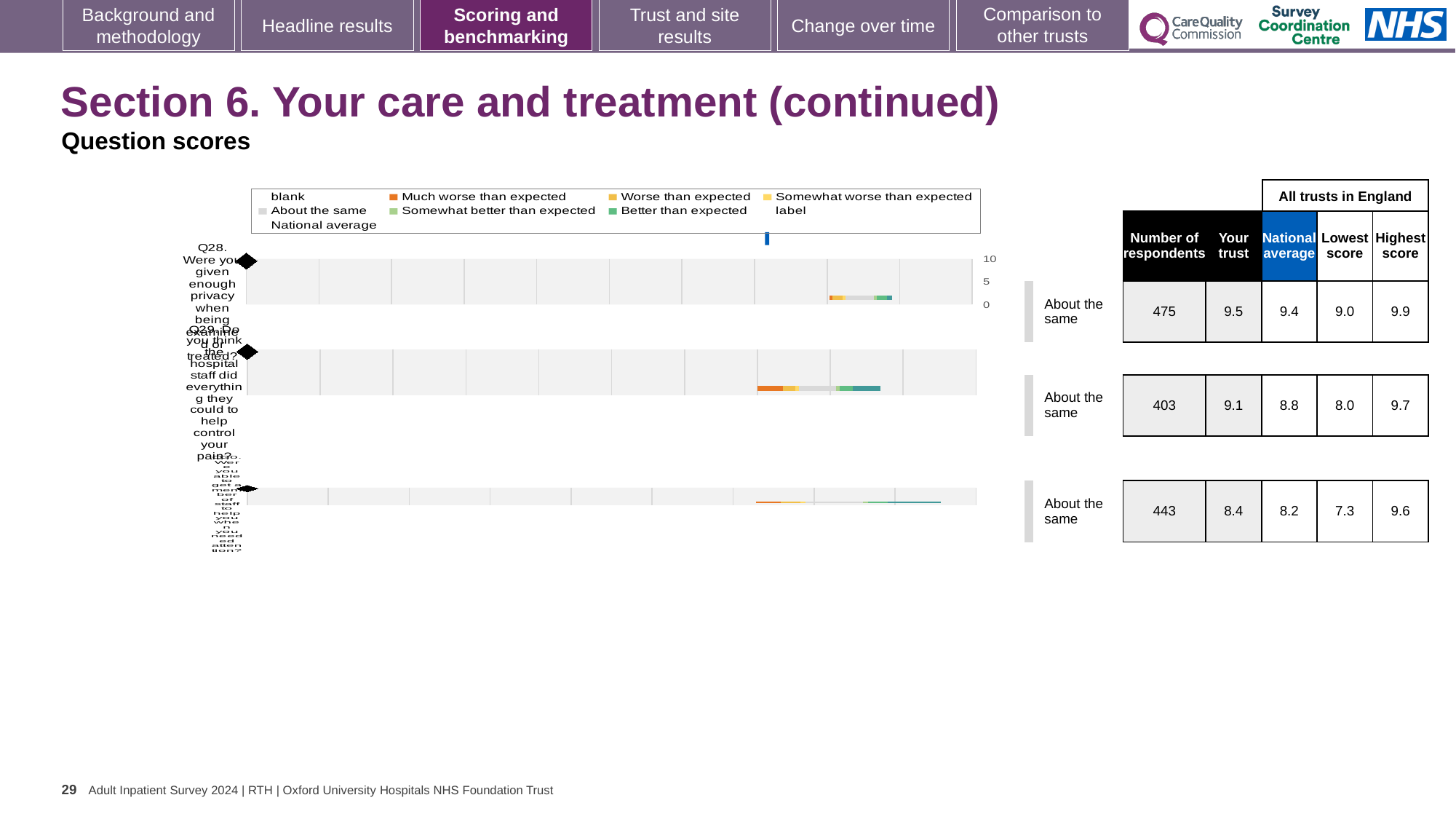
Which question has the highest number of respondents? Q28 Which question has the lowest 'Your trust' score? Q30 What is the 'Your trust' score for Q28 (privacy when being examined or treated)? 9.5 How many respondents answered Q30? 443 What is the highest score among all trusts in England for Q28? 9.9 Which has the higher 'Your trust' score, Q28 or Q29? Q28 What kind of chart is used to show the question scores on this slide? bar chart What benchmark category is shown for Q29? About the same What is the national average score for Q29 (staff did everything to help control your pain)? 8.8 How many survey questions are plotted on this slide? 3 What is the difference between the 'Your trust' score and the national average for Q28? 0.1 What is the lowest score among all trusts in England for Q30? 7.3